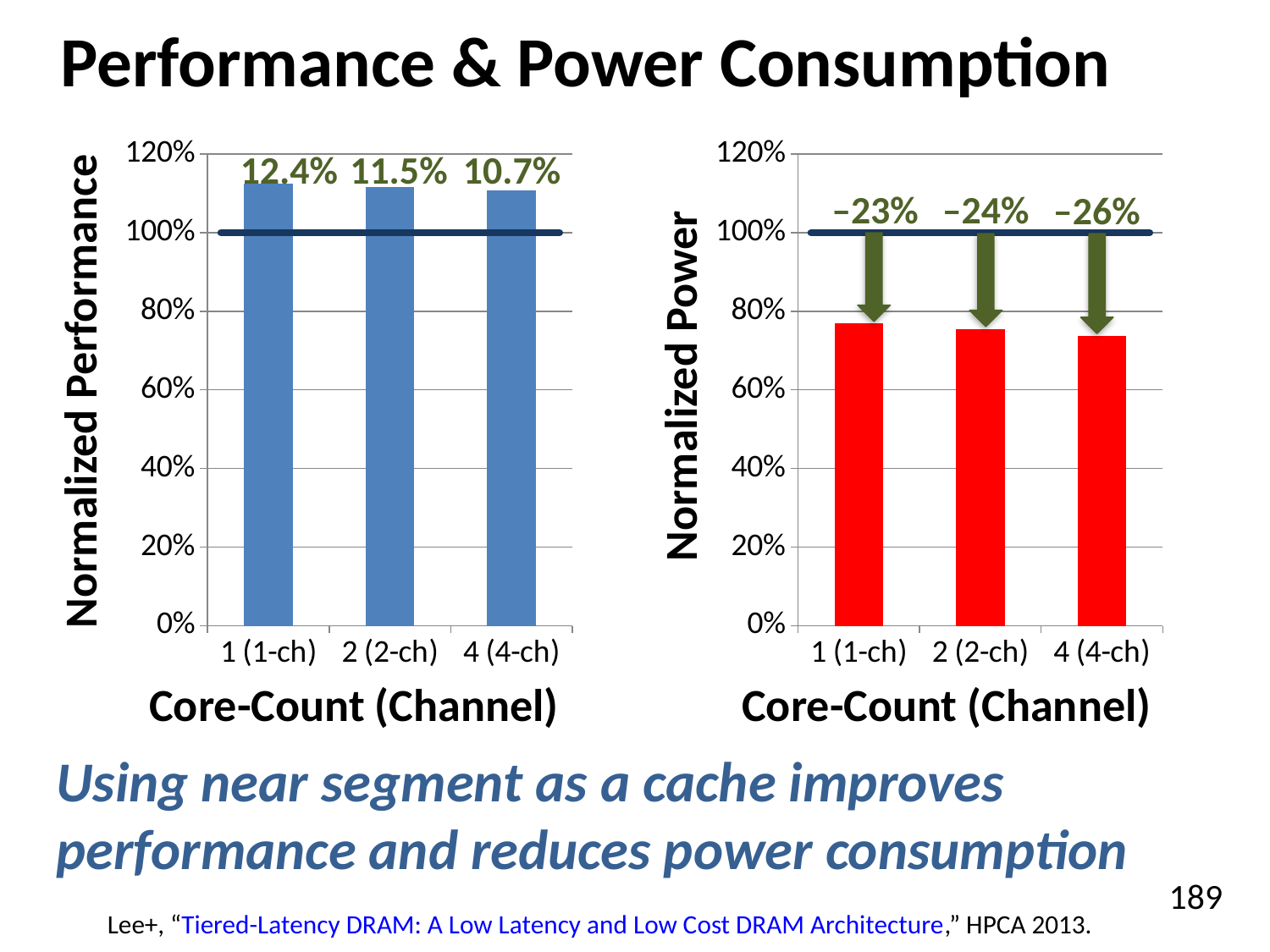
On the Normalized Power chart (right), what label is printed above the 4 (4-ch) bar? –26% On the Normalized Performance chart (left), what label is printed above the 4 (4-ch) bar? 10.7% On the Normalized Power chart (right), which core-count category has the lowest bar? 4 (4-ch) On the Normalized Power chart (right), is the value for 1 (1-ch) greater or less than 80%? less How many core-count categories are shown on the Normalized Power chart (right)? 3 On the Normalized Power chart (right), is the value for 4 (4-ch) greater or less than 60%? greater On the Normalized Power chart (right), do the bar values rise or fall as the core count increases from 1 to 4? fall On the Normalized Performance chart (left), what performance improvement label is printed above the 1 (1-ch) bar? 12.4% On the Normalized Performance chart (left), is the value for 2 (2-ch) greater or less than 100%? greater On the Normalized Power chart (right), what power reduction label is printed above the 2 (2-ch) bar? –24% On the Normalized Performance chart (left), which core-count category has the highest bar? 1 (1-ch) What kind of chart is the Normalized Performance chart (left)? bar chart